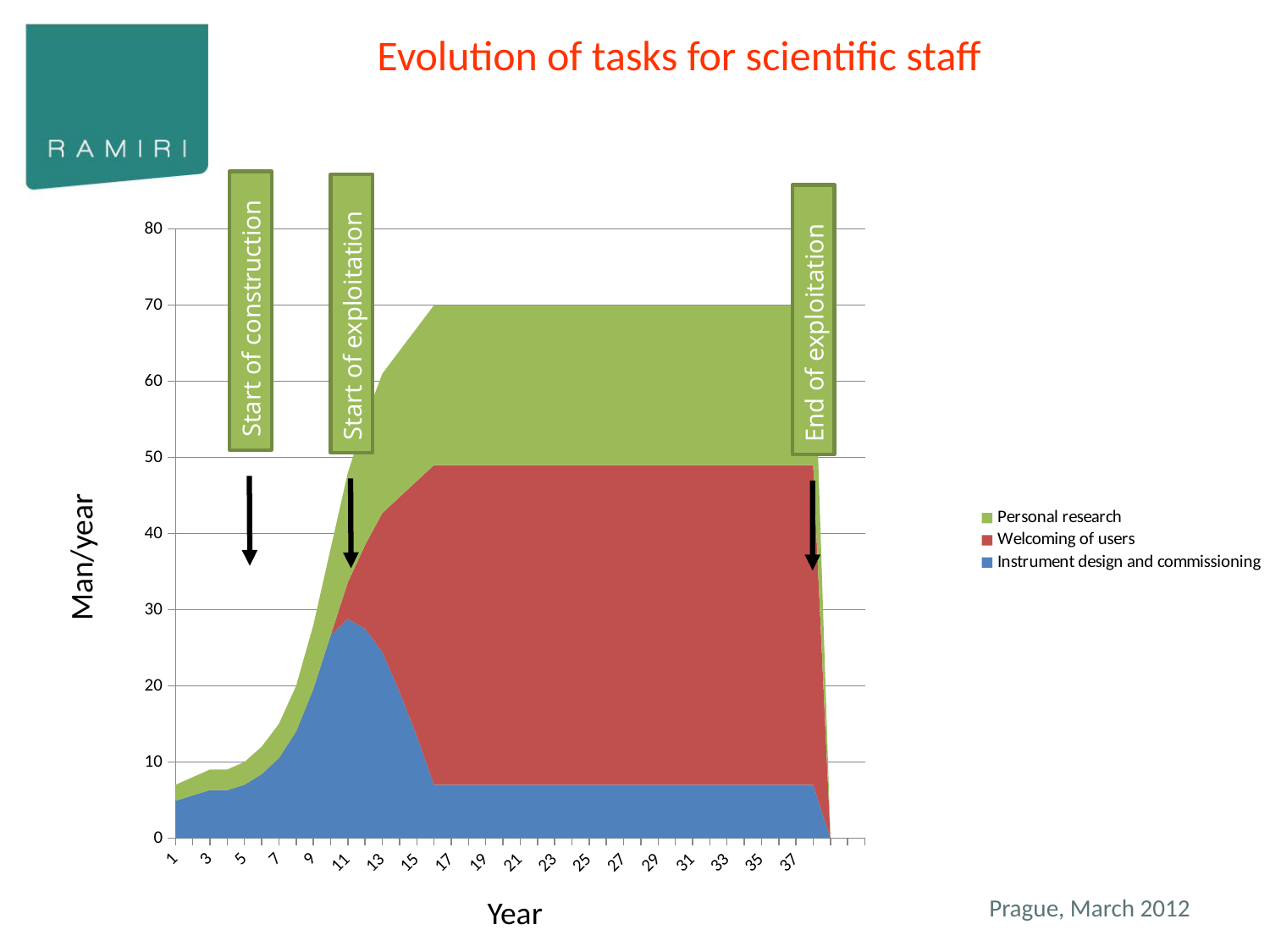
Which series is shown in green in the legend? Personal research How many series does the legend list? 3 Which series has the largest value at year 25: Welcoming of users or Instrument design and commissioning? Welcoming of users Is the total Man/year value at year 25 greater or less than 60? greater Does the total Man/year value rise or fall between year 1 and year 17? rise Is the total Man/year value at year 1 greater or less than 10? less Does the value for Instrument design and commissioning rise or fall between year 11 and year 17? fall What is the title of the chart? Evolution of tasks for scientific staff What kind of chart is shown on the slide? Stacked area chart Is the total Man/year value at year 5 greater or less than 20? less